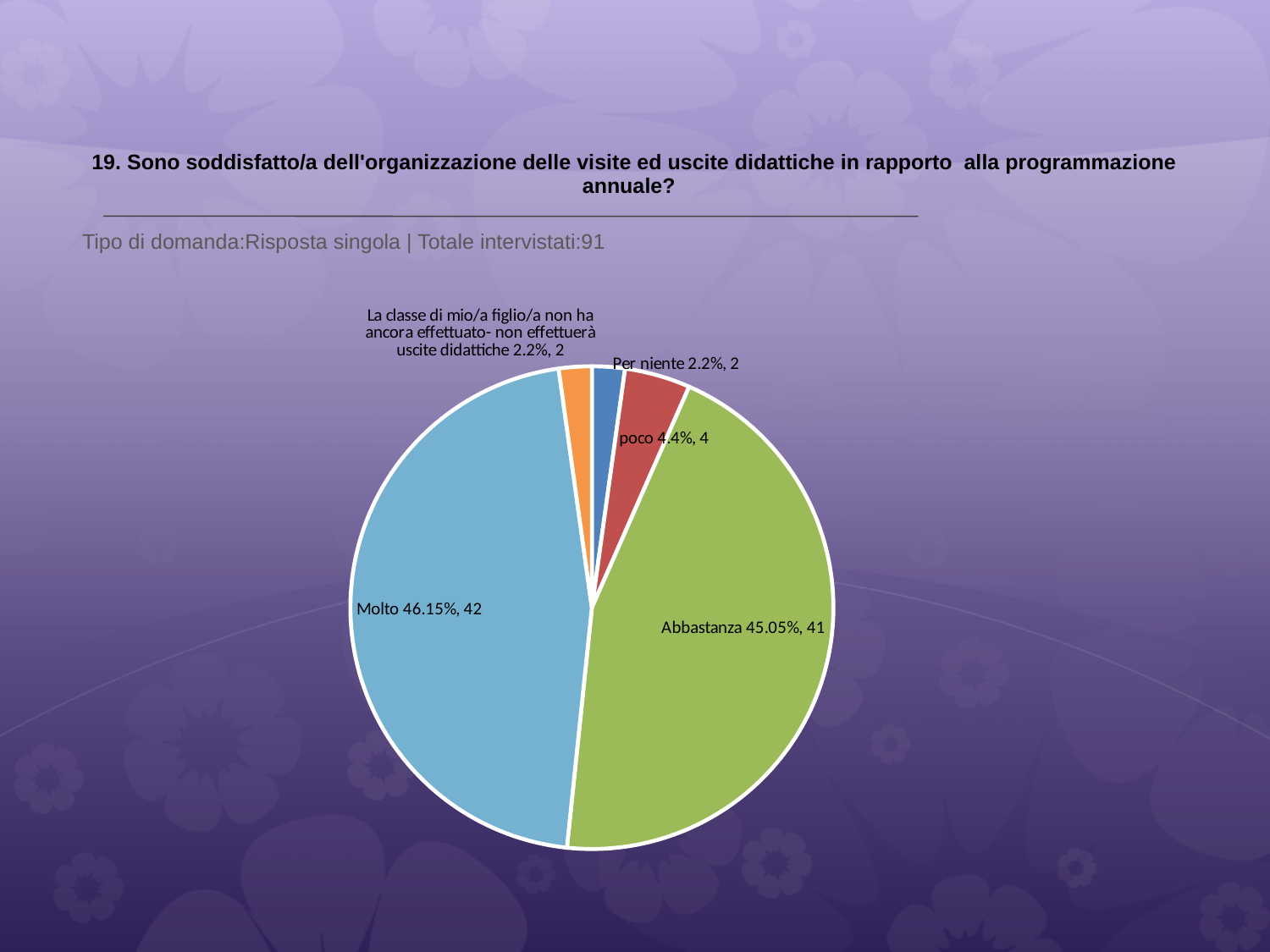
How many slices does the pie chart have? 5 Which response has the largest slice of the pie? Molto What kind of chart is shown on the slide? pie chart How many respondents answered "Per niente"? 2 What percentage share does the "Abbastanza" slice have? 45.05% What is the difference in respondent count between "Molto" and "Abbastanza"? 1 What percentage share does the "Molto" slice have? 46.15% How many respondents answered "Molto"? 42 What percentage share does the slice for "La classe di mio/a figlio/a non ha ancora effettuato- non effettuerà uscite didattiche" have? 2.2% How many respondents answered "poco"? 4 What is the total number of respondents stated on the slide? 91 Which has more respondents, "poco" or "Per niente"? poco